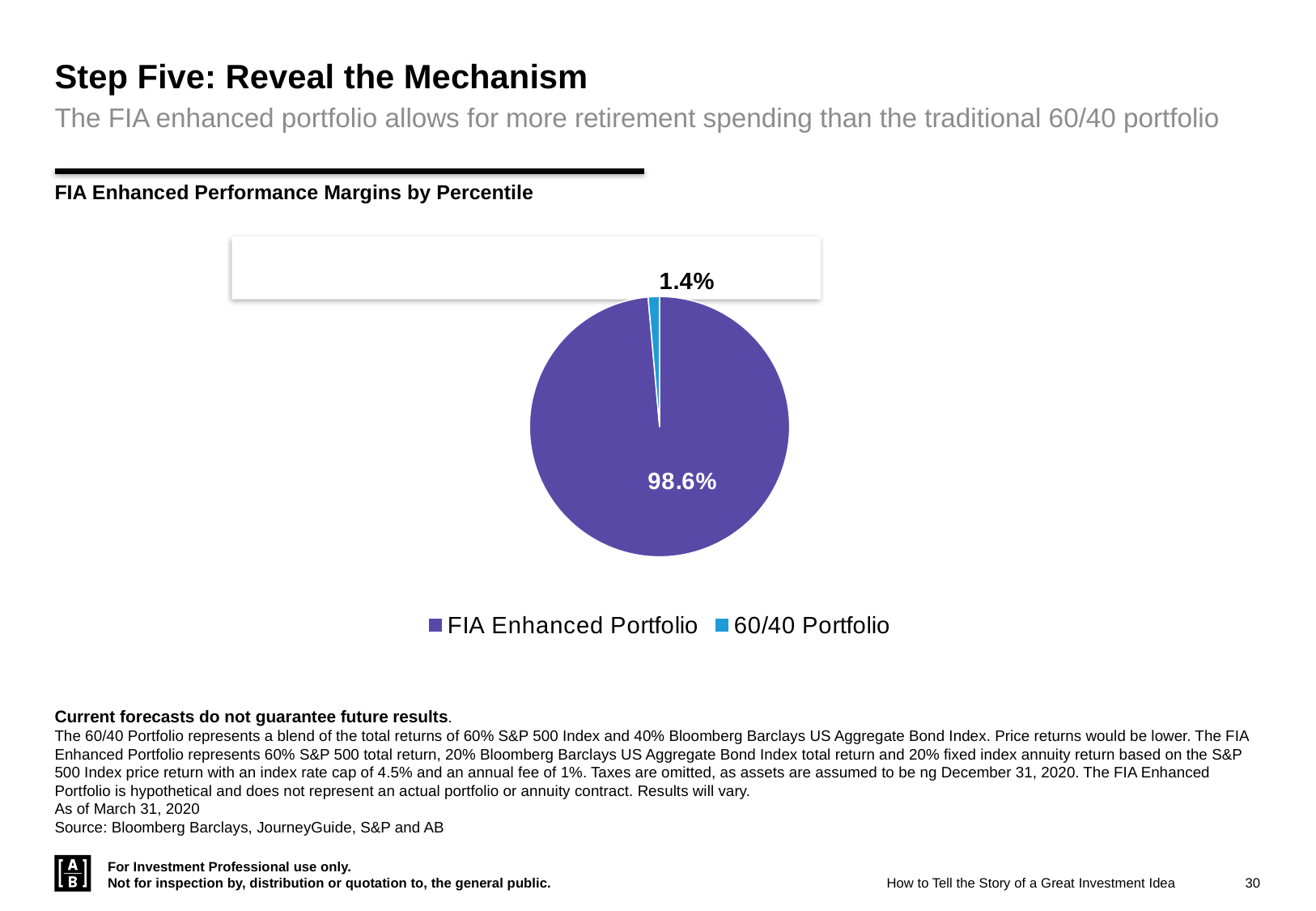
What is the value shown for the 60/40 Portfolio slice? 1.4% Which is larger, the FIA Enhanced Portfolio slice or the 60/40 Portfolio slice? FIA Enhanced Portfolio Which slice of the pie is the smallest? 60/40 Portfolio How many slices does the pie chart have? 2 What share of the pie does the 60/40 Portfolio slice represent? 1.4% What is the title of the chart? FIA Enhanced Performance Margins by Percentile What is the difference between the FIA Enhanced Portfolio and 60/40 Portfolio values? 97.2% Which slice of the pie is the largest? FIA Enhanced Portfolio How many entries does the legend list? 2 What colour is the FIA Enhanced Portfolio slice? Purple What kind of chart is shown on the slide? Pie chart What is the value shown for the FIA Enhanced Portfolio slice? 98.6%